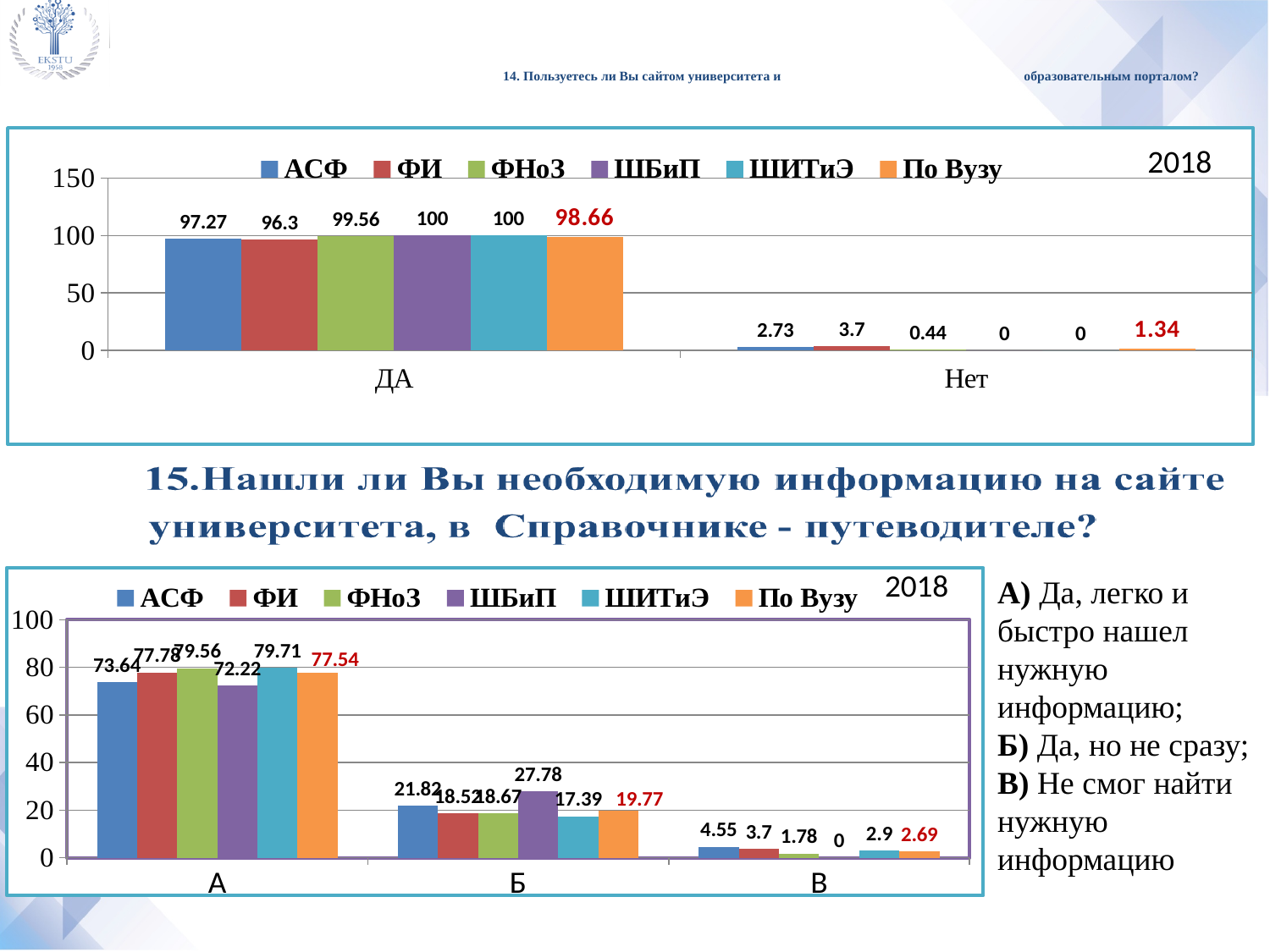
In the top chart, what is the value for ФИ in the ДА category? 96.3 In the bottom chart, what year is shown in the top-right corner? 2018 In the top chart, how many series does the legend list? 6 In the bottom chart, is the value for По Вузу in category Б larger or smaller than the value for ШИТиЭ in category Б? larger In the bottom chart, what is the value for ШБиП in category Б? 27.78 In the top chart, what is the value for По Вузу in the Нет category? 1.34 In the top chart, what is the difference between the АСФ values for ДА and Нет? 94.54 In the bottom chart, what is the value for АСФ in category В? 4.55 What type of chart is the bottom chart? bar chart In the top chart, how many categories are shown on the x axis? 2 In the bottom chart, which series has the lowest value in category А? ШБиП In the top chart, which series has the highest value in the Нет category? ФИ